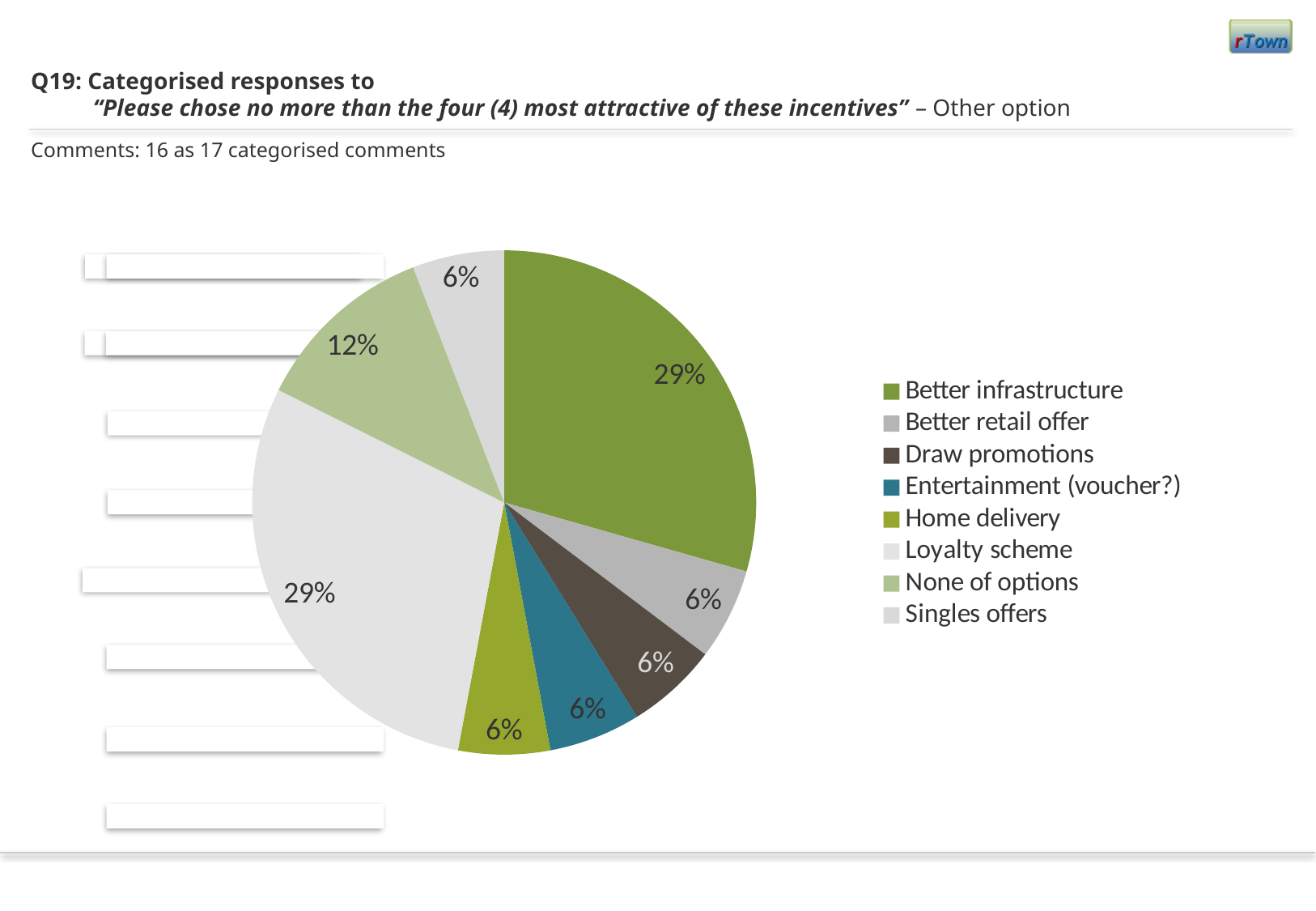
Which legend entry is shown in teal blue? Entertainment (voucher?) How many categories does the legend of the pie chart list? 8 What is the difference in percentage points between the share for None of options and the share for Entertainment (voucher?)? 6 What kind of chart is shown on the slide? pie chart What share of the pie does Home delivery represent? 6% What share of the pie does Better infrastructure represent? 29% Which is larger, the share for None of options or the share for Better retail offer? None of options What is the difference in percentage points between the share for Better infrastructure and the share for None of options? 17 What share of the pie does None of options represent? 12%